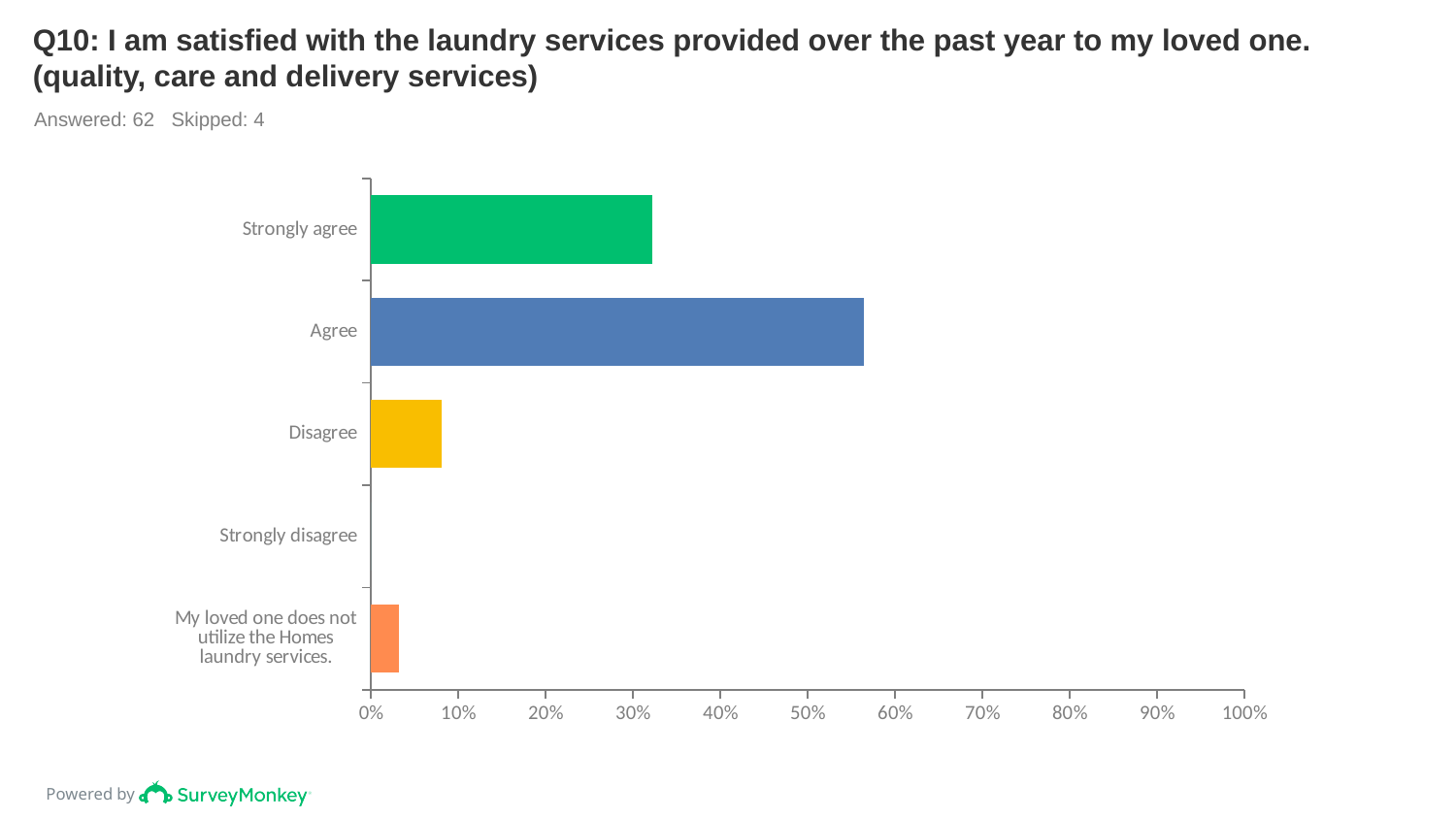
What kind of chart is shown on the slide? bar chart Is the value for Disagree greater or less than 10%? less Which is larger, the value for Disagree or the value for 'My loved one does not utilize the Homes laundry services.'? Disagree Which response category has the lowest value? Strongly disagree Which response category has the highest value? Agree What colour is the bar for Agree? blue What is the value for Strongly disagree? 0% How many response categories are shown on the chart? 5 Is the value for Strongly agree greater or less than 30%? greater Is the value for Agree greater or less than 50%? greater Which is larger, the value for Agree or the value for Strongly agree? Agree